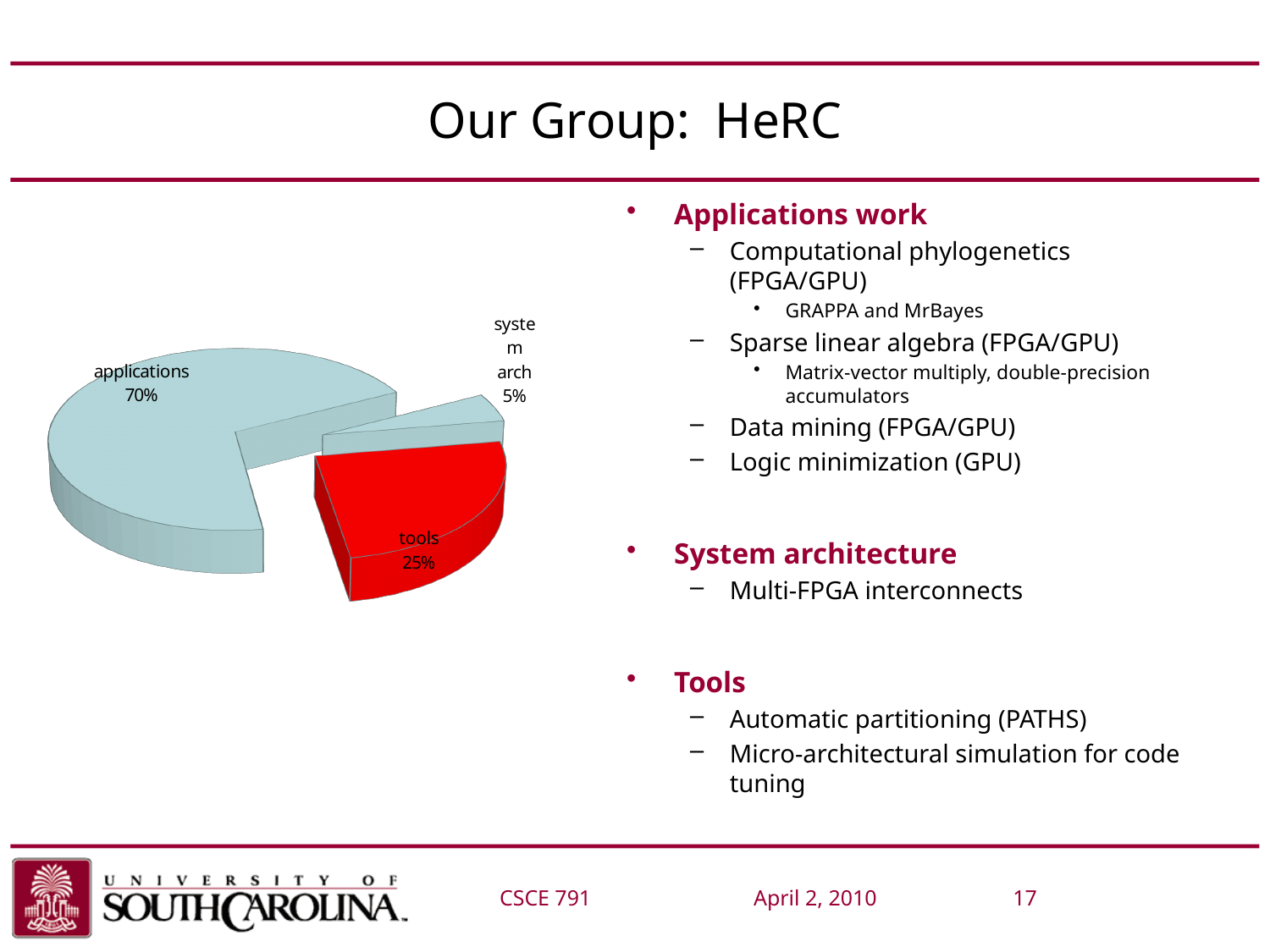
What colour is the tools slice of the pie chart? red What share of the pie does the applications slice represent? 70% What share of the pie does the tools slice represent? 25% What is the difference in percentage points between the tools slice and the system arch slice? 20 What is the combined share of the tools and system arch slices? 30% What is the difference in percentage points between the applications slice and the tools slice? 45 What share of the pie does the system arch slice represent? 5% Which is larger, the tools slice or the system arch slice? tools How many slices does the pie chart have? 3 Which slice of the pie is the largest? applications What kind of chart is shown on the slide? pie chart Which slice of the pie is the smallest? system arch